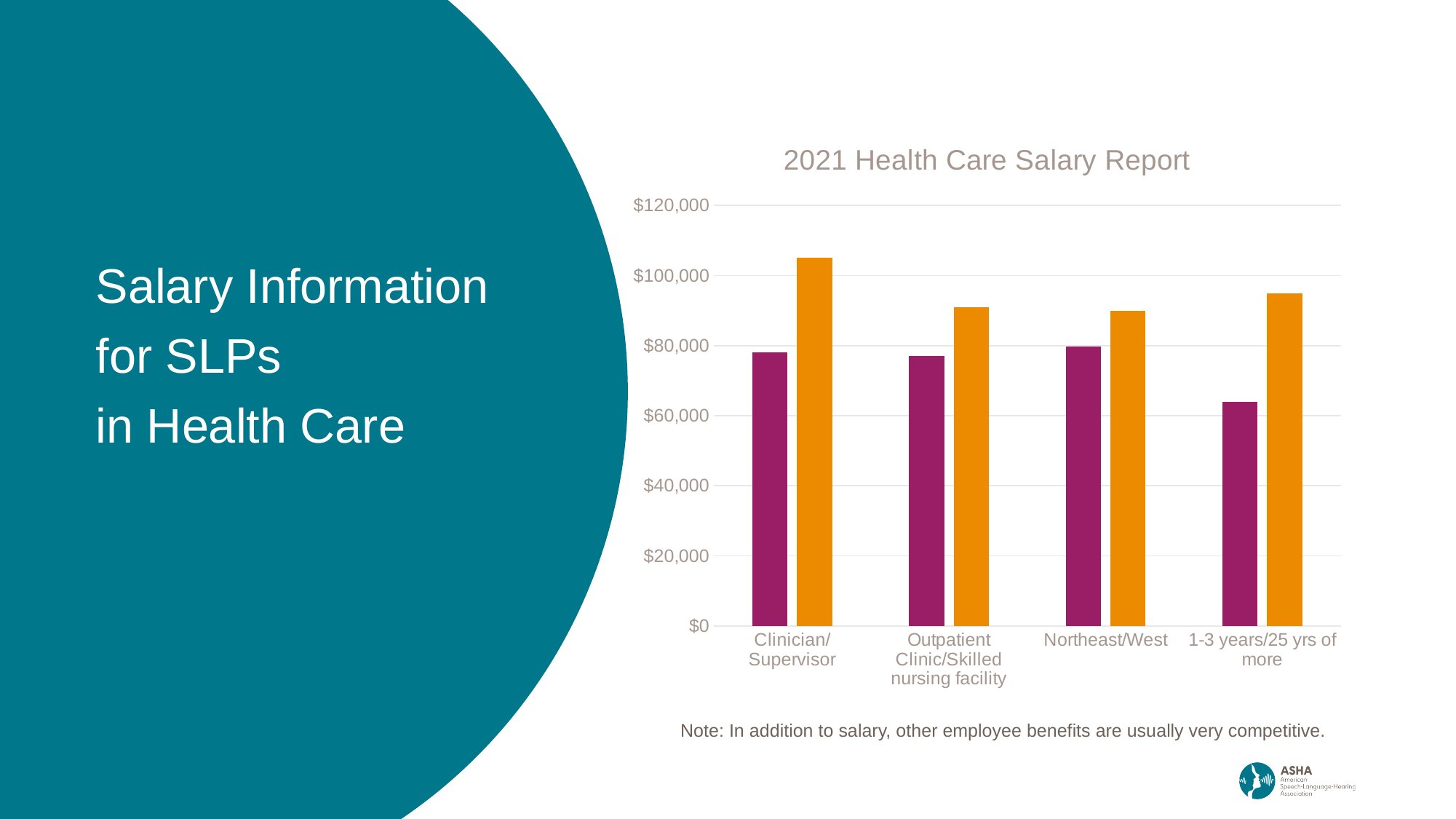
What colours are the two series of bars in the chart? purple and orange What is the title of the chart? 2021 Health Care Salary Report Is the orange bar for Clinician/Supervisor greater or less than $100,000? greater Which category has the tallest orange bar? Clinician/Supervisor What kind of chart is shown on the slide? bar chart How many categories are shown on the x axis of the chart? 4 Which category has the shortest purple bar? 1-3 years/25 yrs of more Is the orange bar for Northeast/West greater or less than $100,000? less In the 1-3 years/25 yrs of more category, which bar is taller, the purple bar or the orange bar? the orange bar Is the purple bar for 1-3 years/25 yrs of more greater or less than $80,000? less